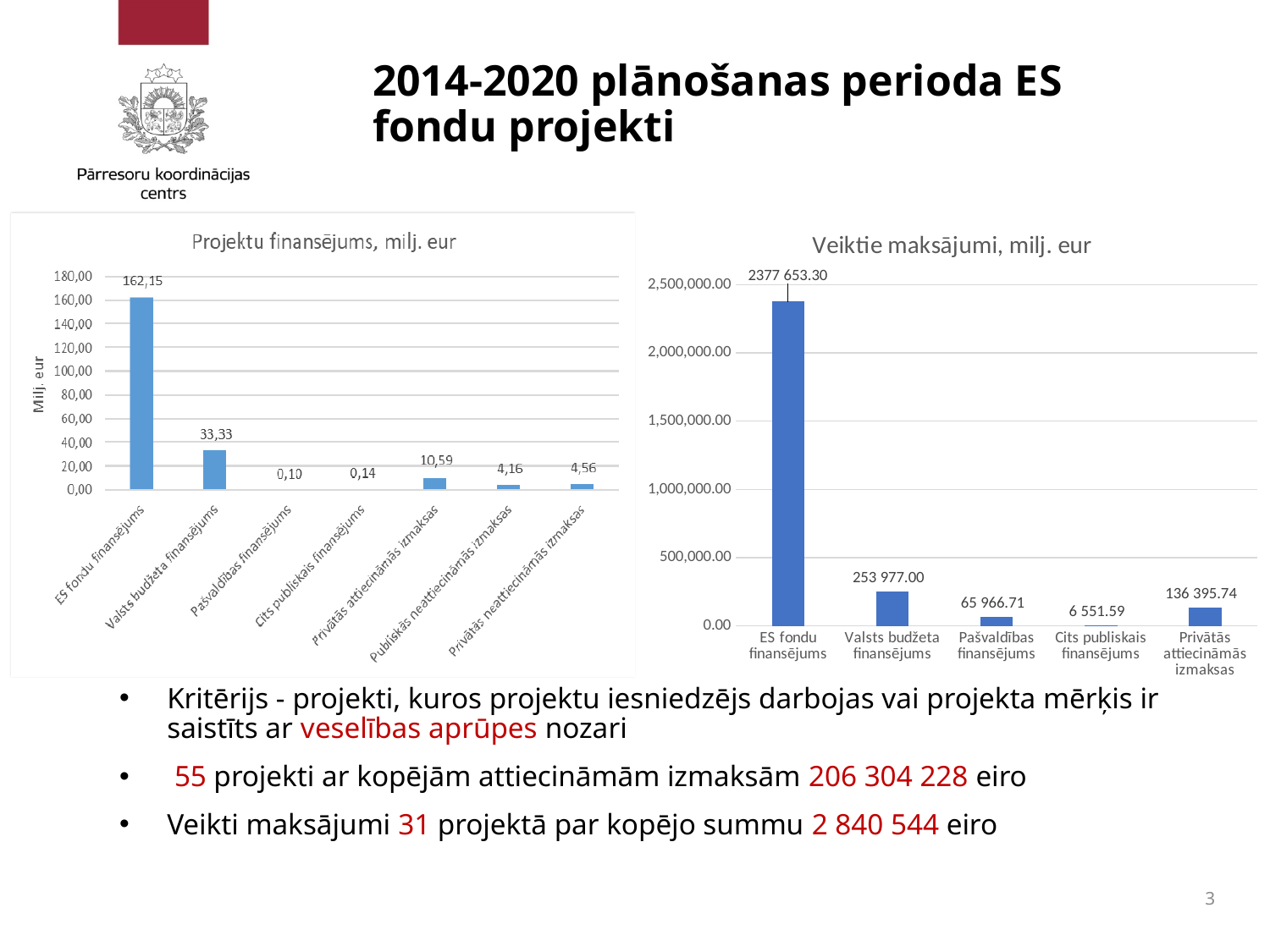
What kind of chart is the chart titled "Veiktie maksājumi, milj. eur"? bar chart In the chart titled "Veiktie maksājumi, milj. eur", what is the value for Valsts budžeta finansējums? 253 977.00 In the chart titled "Projektu finansējums, milj. eur", which is larger: Privātās attiecināmās izmaksas or Publiskās neattiecināmās izmaksas? Privātās attiecināmās izmaksas In the chart titled "Veiktie maksājumi, milj. eur", how many categories are shown on the x axis? 5 In the chart titled "Projektu finansējums, milj. eur", what is the value for ES fondu finansējums? 162,15 In the chart titled "Veiktie maksājumi, milj. eur", what is the value for Cits publiskais finansējums? 6 551.59 In the chart titled "Projektu finansējums, milj. eur", how many categories are shown on the x axis? 7 In the chart titled "Projektu finansējums, milj. eur", which category has the lowest value? Pašvaldības finansējums In the chart titled "Veiktie maksājumi, milj. eur", is the value for ES fondu finansējums greater or less than 2,000,000.00? greater In the chart titled "Projektu finansējums, milj. eur", what is the value for Valsts budžeta finansējums? 33,33 In the chart titled "Projektu finansējums, milj. eur", what is the difference between ES fondu finansējums and Valsts budžeta finansējums? 128,82 In the chart titled "Veiktie maksājumi, milj. eur", which category has the highest value? ES fondu finansējums